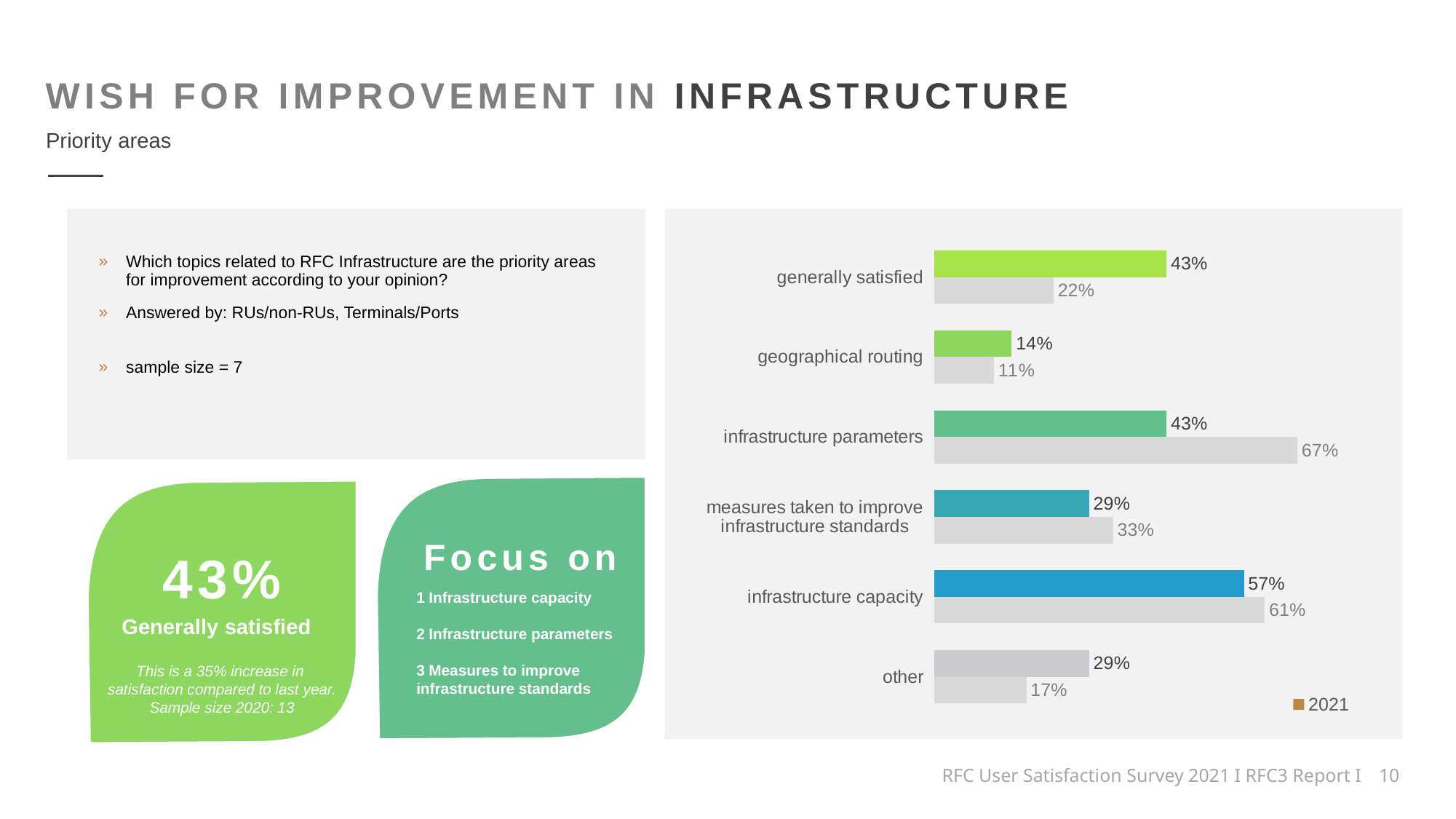
What is the 2021 value for infrastructure capacity? 57% Which category has the highest 2021 value? infrastructure capacity Which series is listed in the chart legend? 2021 Which is larger for infrastructure parameters: the 2021 value or the grey bar value? the grey bar value What is the difference between the 2021 value for infrastructure capacity and the 2021 value for geographical routing? 43% What kind of chart is shown on the slide? bar chart How many categories are shown on the chart? 6 For generally satisfied, what is the difference between the 2021 value and the grey bar value? 21% Which is larger: the 2021 value for measures taken to improve infrastructure standards or the 2021 value for infrastructure capacity? infrastructure capacity What value is shown on the grey bar for infrastructure parameters? 67% What is the 2021 value for geographical routing? 14% Which category has the lowest 2021 value? geographical routing